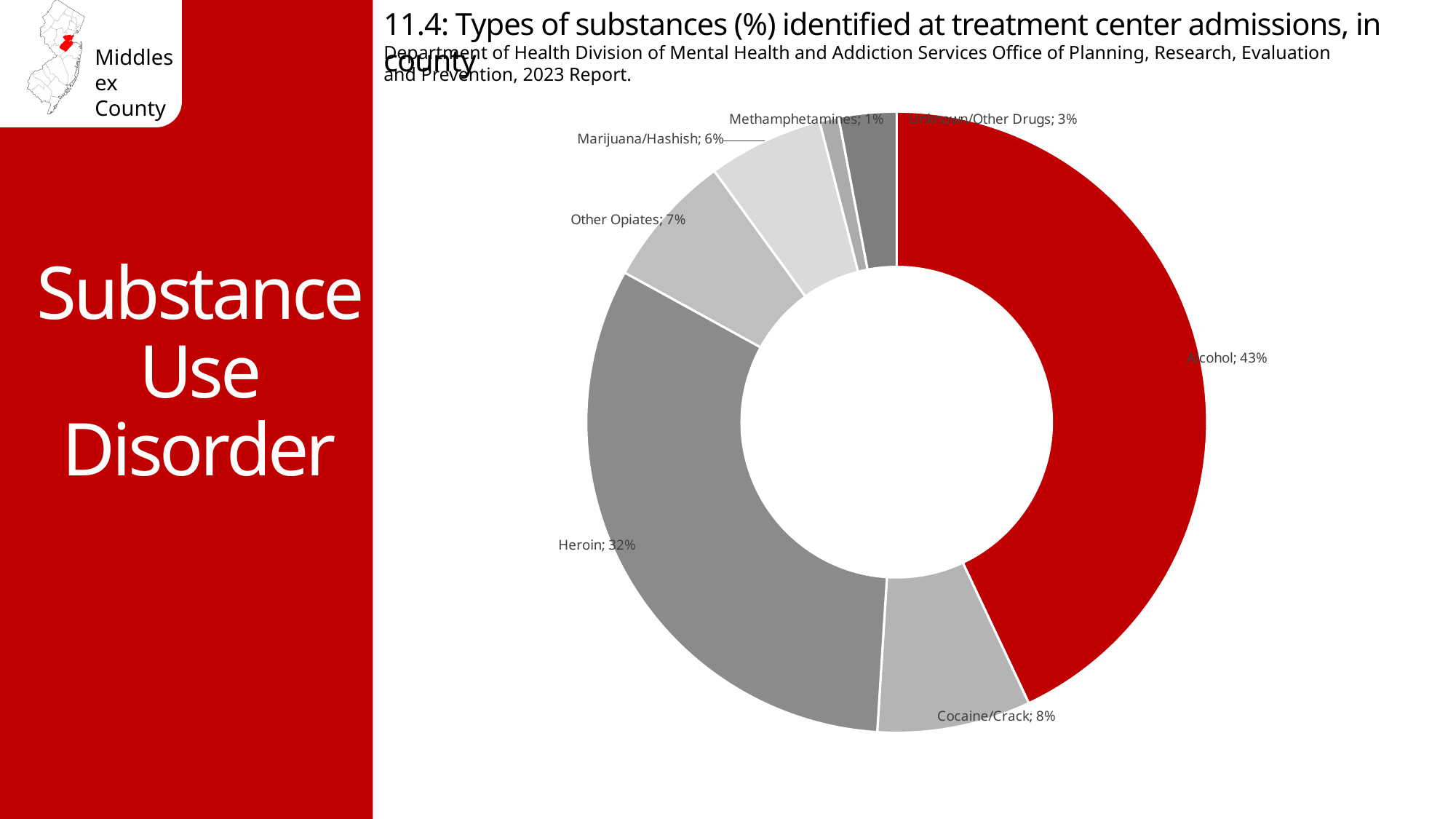
What percentage is shown for Methamphetamines? 1% Which has a larger share, Marijuana/Hashish or Unknown/Other Drugs? Marijuana/Hashish Which substance has the smallest share of admissions? Methamphetamines What is the value shown for Cocaine/Crack? 8% What percentage of treatment center admissions is attributed to Alcohol? 43% How many substance categories are shown in the chart? 7 What is the difference in percentage points between Alcohol and Heroin? 11 Which substance has the largest share of admissions? Alcohol What is the combined share of Alcohol and Heroin? 75% What percentage is shown for Heroin? 32% What percentage is shown for Other Opiates? 7% What kind of chart is used on this slide? Doughnut (pie) chart